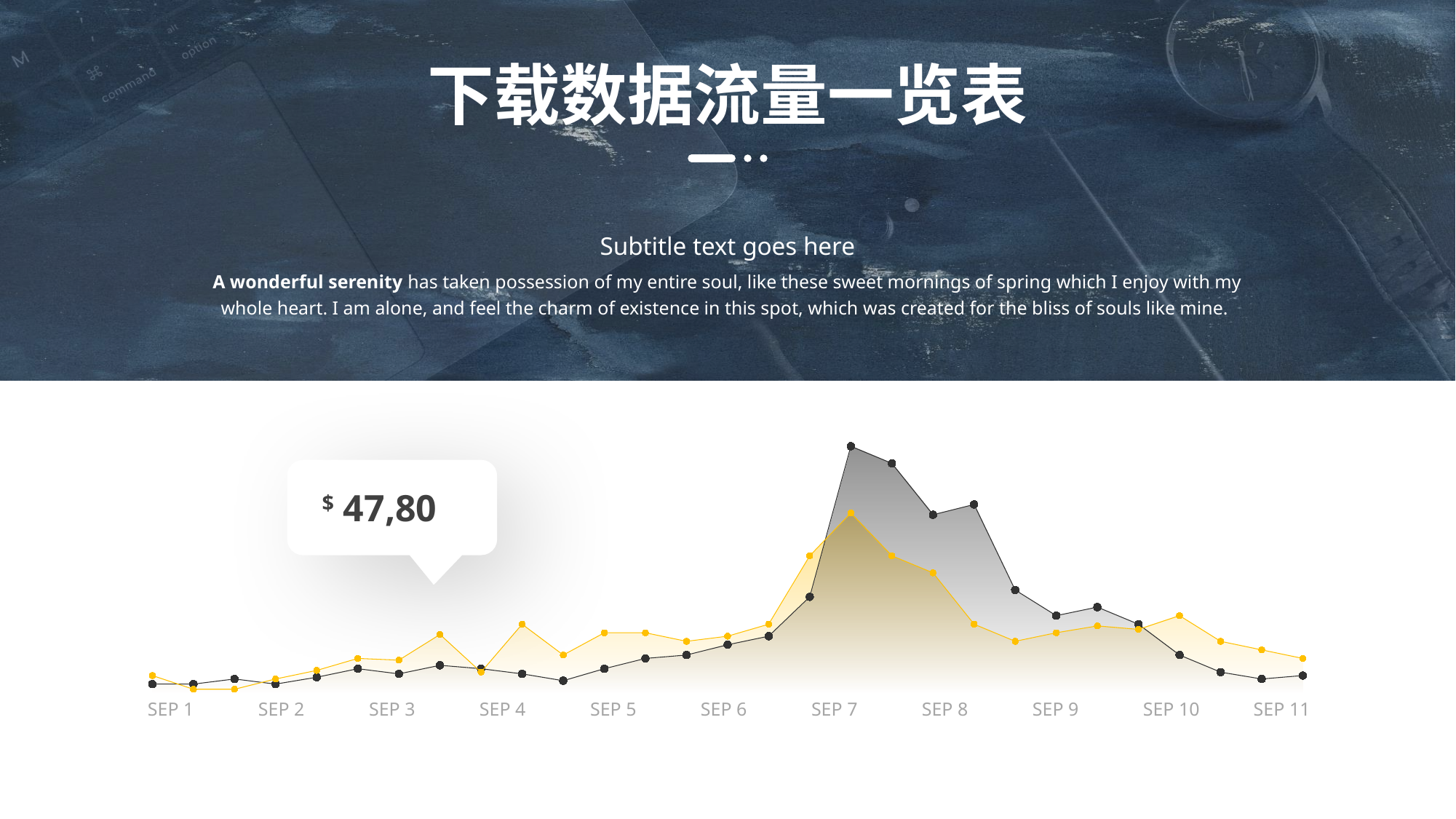
At which date does the black series reach its highest point? SEP 7 At SEP 11, which series is higher, the black series or the yellow series? Yellow series How many data series are plotted in the chart? 2 At which date does the yellow series reach its highest point? SEP 7 Do the values of the black series rise or fall from SEP 7 to SEP 11? Fall How many dates are labelled along the x axis of the chart? 11 What kind of chart is shown on the slide? Area chart What value is shown in the callout box above the chart? $ 47,80 At SEP 7, which series is higher, the black series or the yellow series? Black series What is the title of the slide containing the chart? 下载数据流量一览表 Do the values of the black series rise or fall from SEP 5 to SEP 7? Rise